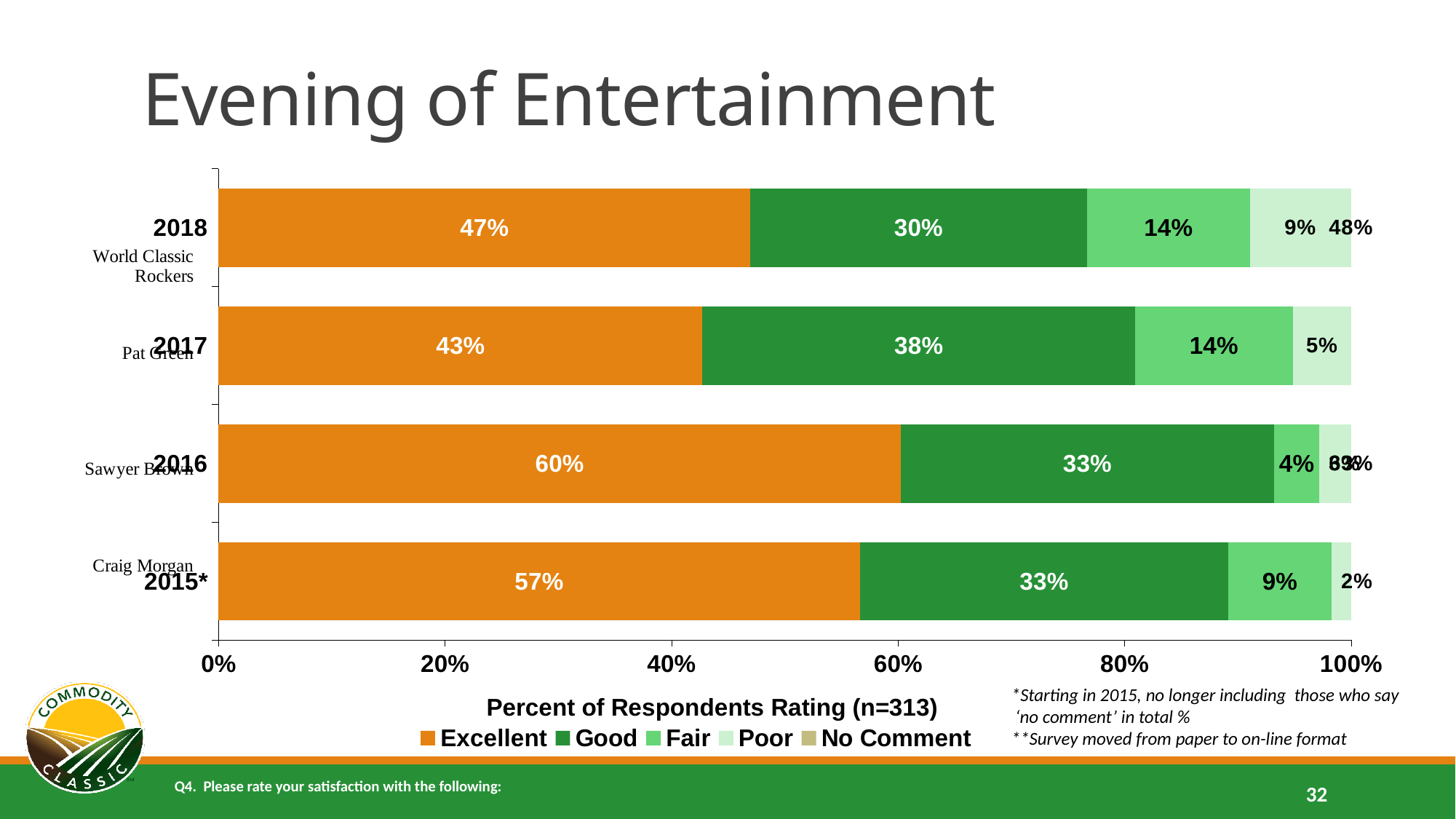
What is the difference between the Excellent rating in 2016 and in 2017? 17 percentage points What kind of chart is shown on the slide? Stacked bar chart Which year has the lowest Excellent rating? 2017 What is the title of the chart's horizontal axis? Percent of Respondents Rating (n=313) What is the Good value for 2017? 38% How many years are shown on the chart? 4 What is the Poor value for 2017? 5% Which year has the larger Good rating, 2017 or 2018? 2017 What percentage of respondents rated the 2018 Evening of Entertainment as Excellent? 47% What is the Fair value for 2015*? 9% Which year has the highest Excellent rating? 2016 How many series does the legend list? 5